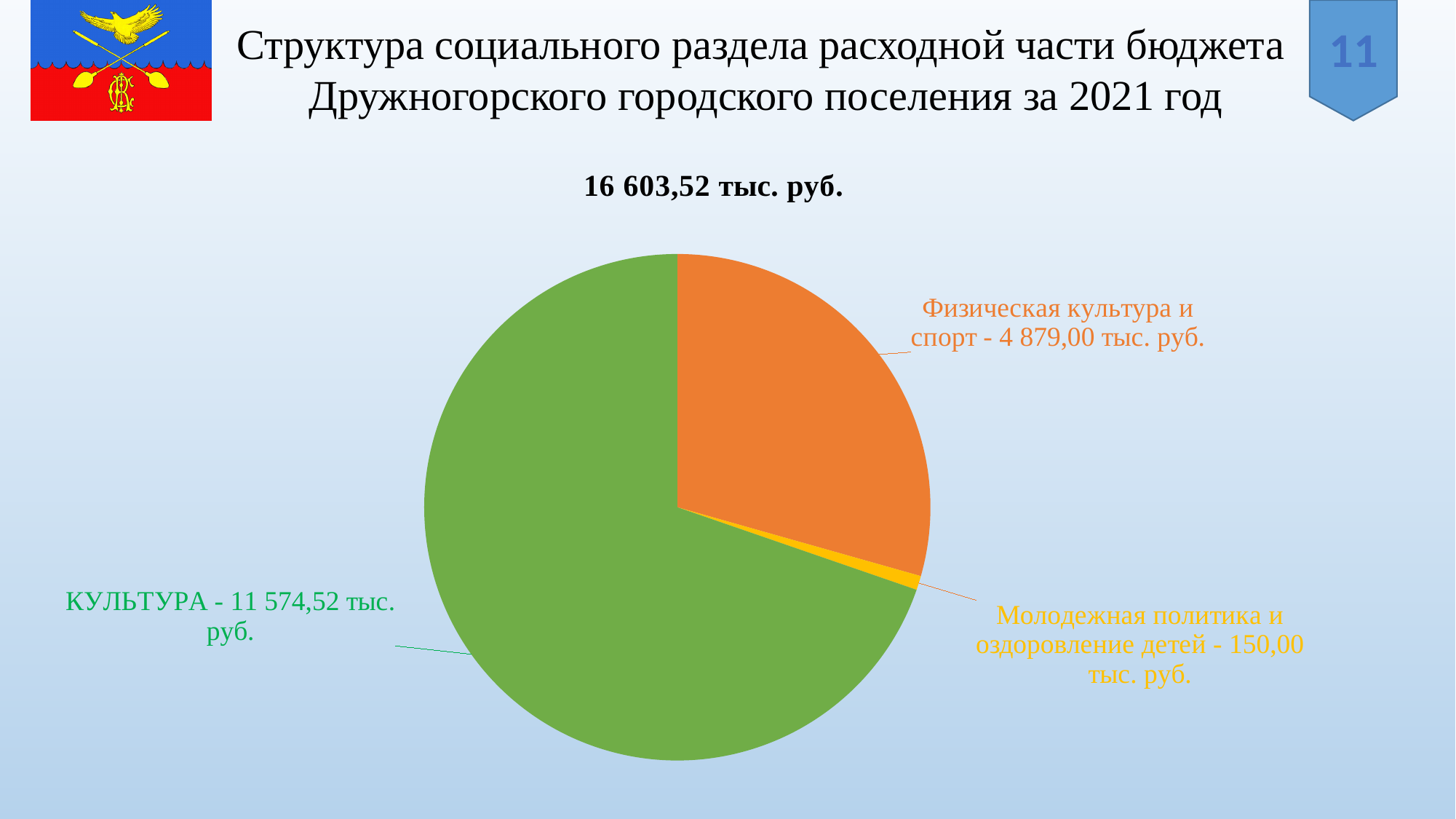
Which category has the smallest slice of the pie? Молодежная политика и оздоровление детей What is the difference between the values for Физическая культура и спорт and Молодежная политика и оздоровление детей? 4 729,00 тыс. руб. What is the value for Молодежная политика и оздоровление детей? 150,00 тыс. руб. Which is larger: the value for Физическая культура и спорт or the value for Молодежная политика и оздоровление детей? Физическая культура и спорт What is the difference between the values for КУЛЬТУРА and Физическая культура и спорт? 6 695,52 тыс. руб. How many slices does the pie chart have? 3 What is the value for Физическая культура и спорт? 4 879,00 тыс. руб. What colour is the slice for Физическая культура и спорт? orange Which category has the largest slice of the pie? КУЛЬТУРА What type of chart is shown on the slide? pie chart What is the value for КУЛЬТУРА? 11 574,52 тыс. руб. What is the total amount shown above the pie chart? 16 603,52 тыс. руб.